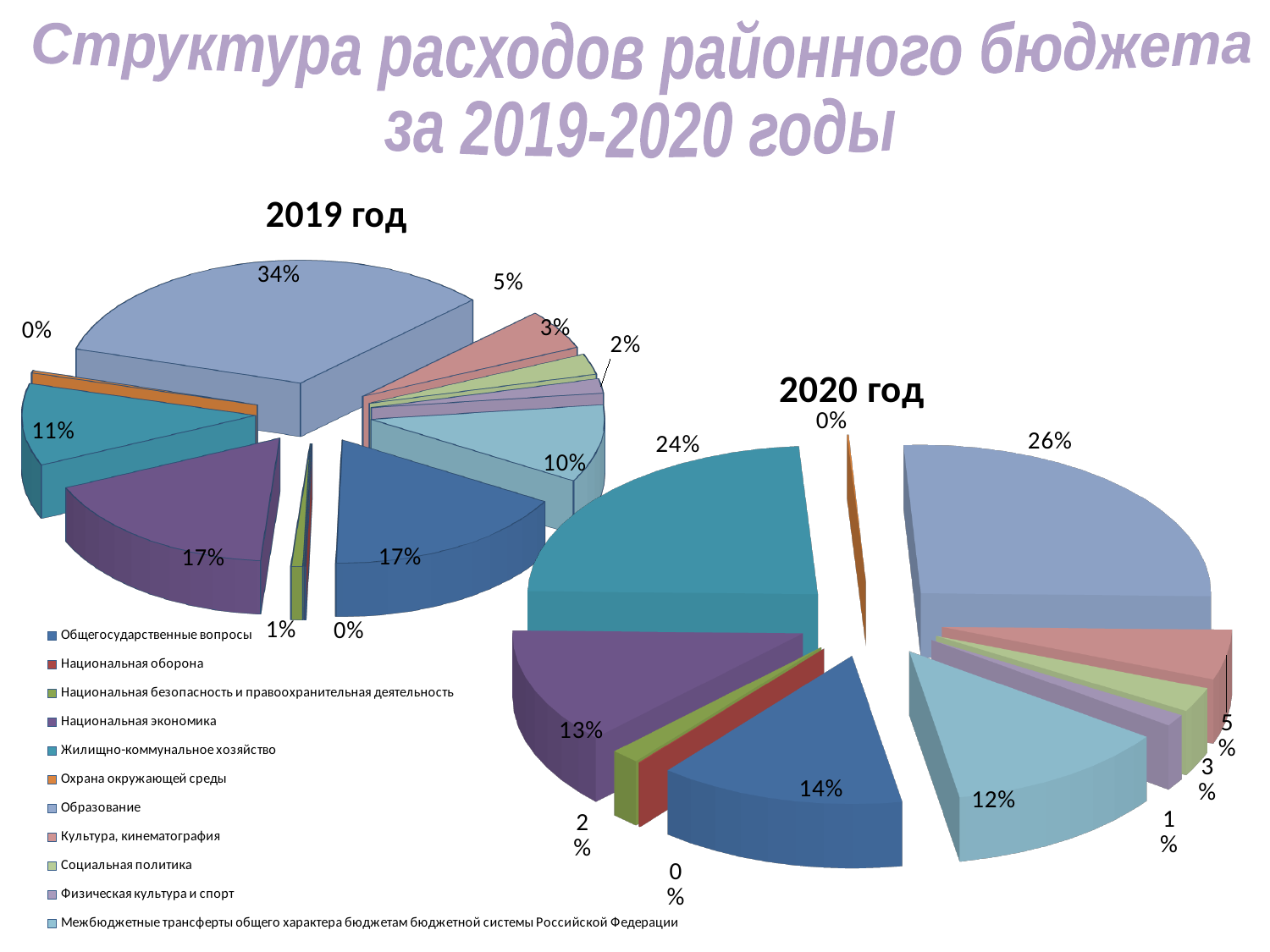
What is the title of the slide? Структура расходов районного бюджета за 2019-2020 годы In the "2019 год" chart, what is the largest share shown? 34% In the "2020 год" chart, what share is shown for Жилищно-коммунальное хозяйство? 24% In the "2019 год" chart, what share is shown for Жилищно-коммунальное хозяйство? 11% In the "2019 год" chart, what share is shown for Образование? 34% What kind of charts are shown on the slide? Pie charts In the "2020 год" chart, what is the largest share shown? 26% Which chart shows a larger share for Жилищно-коммунальное хозяйство, "2019 год" or "2020 год"? 2020 год How many categories does the legend list? 11 In the "2020 год" chart, what share is shown for Образование? 26% By how many percentage points did the share of Образование fall from the "2019 год" chart to the "2020 год" chart? 8% In the "2020 год" chart, what share is shown for Межбюджетные трансферты общего характера бюджетам бюджетной системы Российской Федерации? 12%